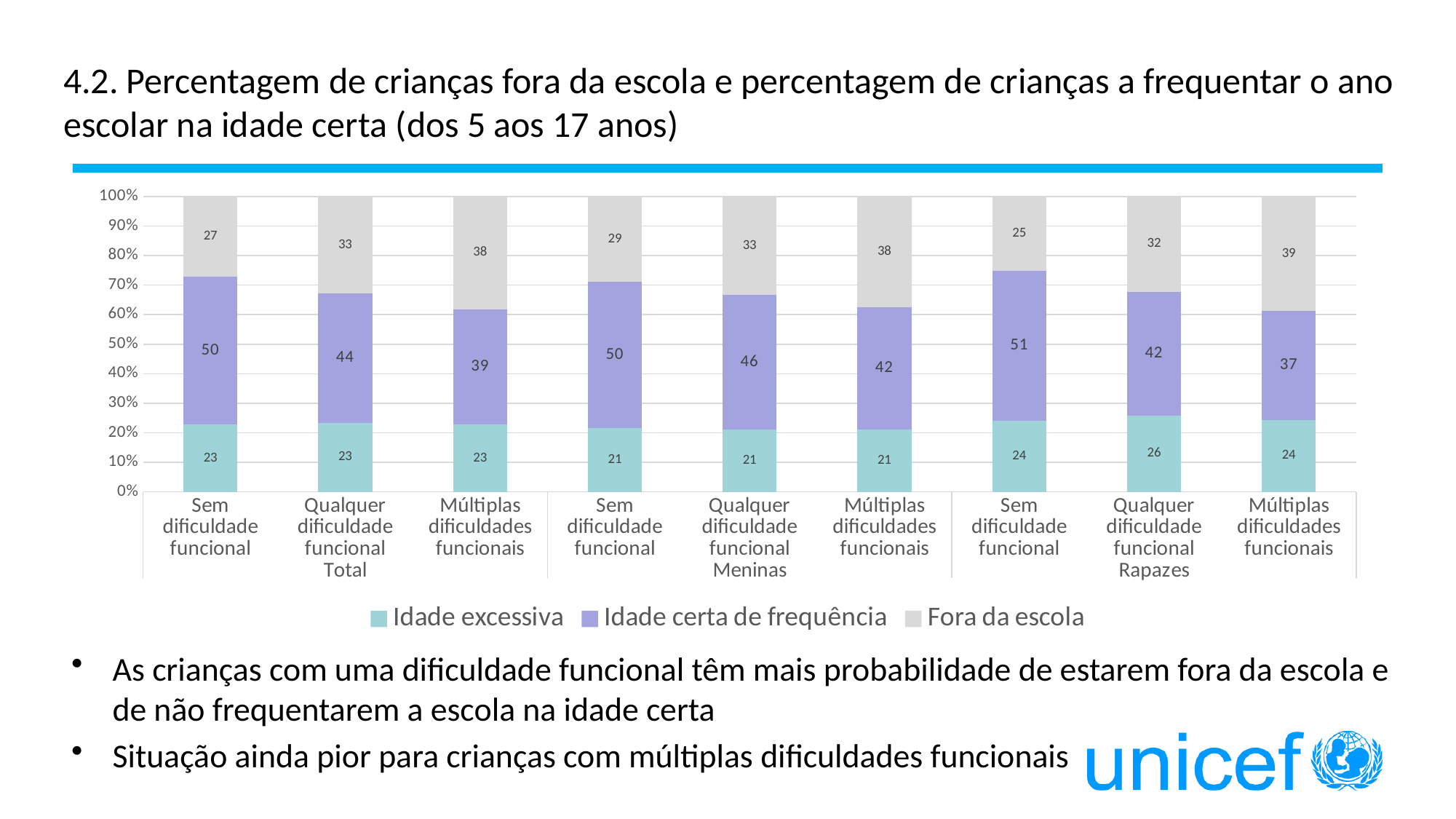
Which is larger: the 'Fora da escola' value for 'Sem dificuldade funcional' in the Meninas group or in the Rapazes group? Meninas Within the Total group, does the 'Fora da escola' value rise or fall from 'Sem dificuldade funcional' to 'Múltiplas dificuldades funcionais'? Rise What is the 'Fora da escola' value for 'Múltiplas dificuldades funcionais' in the Total group? 38 Which bar has the lowest 'Idade certa de frequência' value? Múltiplas dificuldades funcionais (Rapazes) Which series is shown in grey in the legend? Fora da escola How many bars are plotted in the chart? 9 What is the 'Idade excessiva' value for 'Qualquer dificuldade funcional' in the Meninas group? 21 What is the difference between the 'Idade certa de frequência' values for 'Sem dificuldade funcional' and 'Múltiplas dificuldades funcionais' in the Total group? 11 What kind of chart is shown on the slide? Stacked bar chart Which bar has the highest 'Fora da escola' value? Múltiplas dificuldades funcionais (Rapazes) What is the 'Idade certa de frequência' value for 'Sem dificuldade funcional' in the Rapazes group? 51 How many series does the legend list? 3